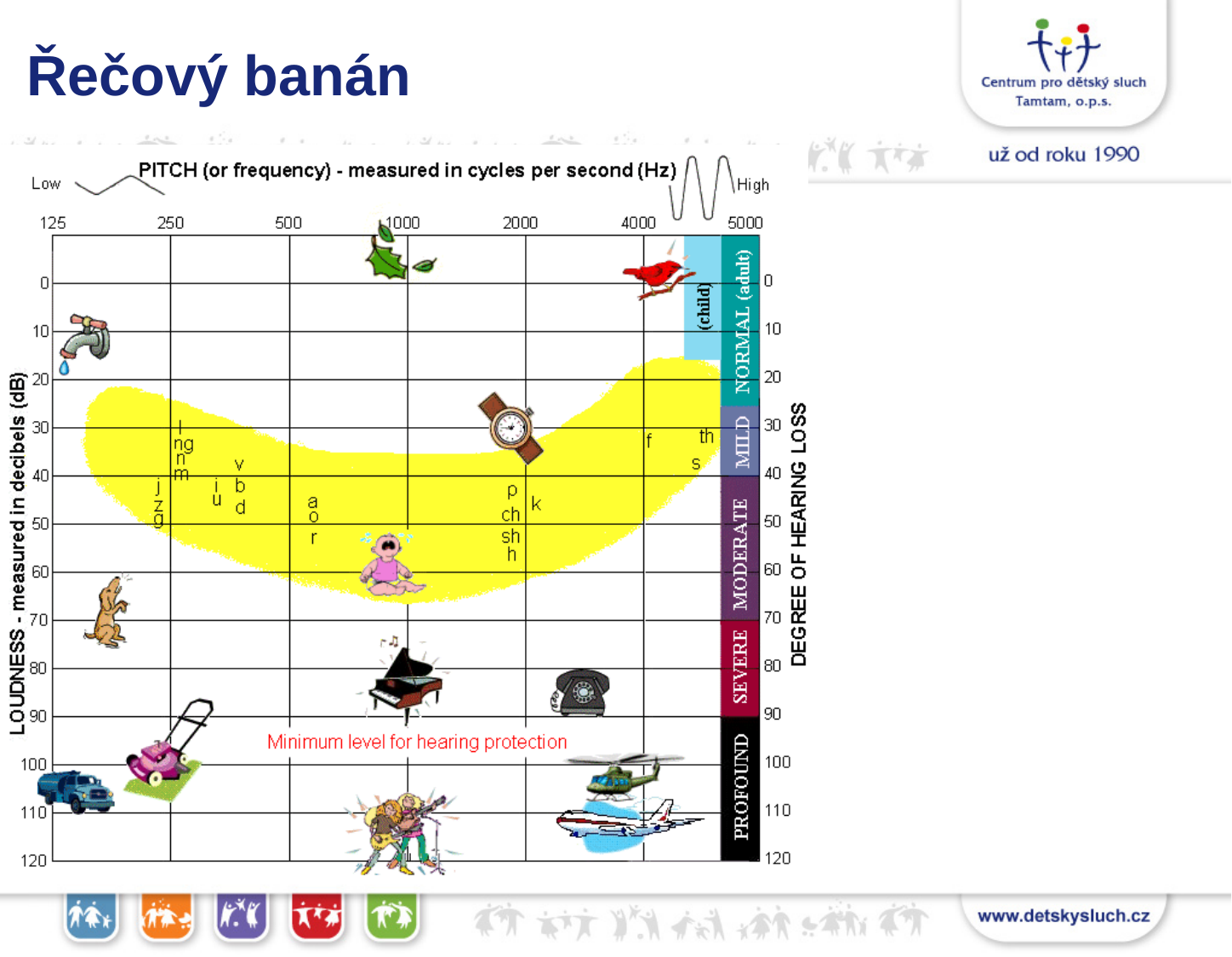
What is the title of the slide containing the chart? Řečový banán What is the highest frequency marked on the top axis of the chart? 5000 What is the lowest frequency marked on the top axis of the chart? 125 How many degree-of-hearing-loss categories are listed on the right side of the chart? 5 Which sound is plotted at a higher frequency, 'f' or 'm'? f Is the loudness at which the sound 'f' is plotted greater or less than 40 dB? less Which degree-of-hearing-loss category is at the bottom of the right-hand scale? PROFOUND Is the loudness at which the sound 'h' is plotted greater or less than 60 dB? greater What is the largest loudness value shown on the vertical axis of the chart? 120 How many frequency values are marked along the top axis of the chart? 7 Which degree-of-hearing-loss category is at the top of the right-hand scale? NORMAL What is the label of the horizontal (pitch) axis of the chart? PITCH (or frequency) - measured in cycles per second (Hz)